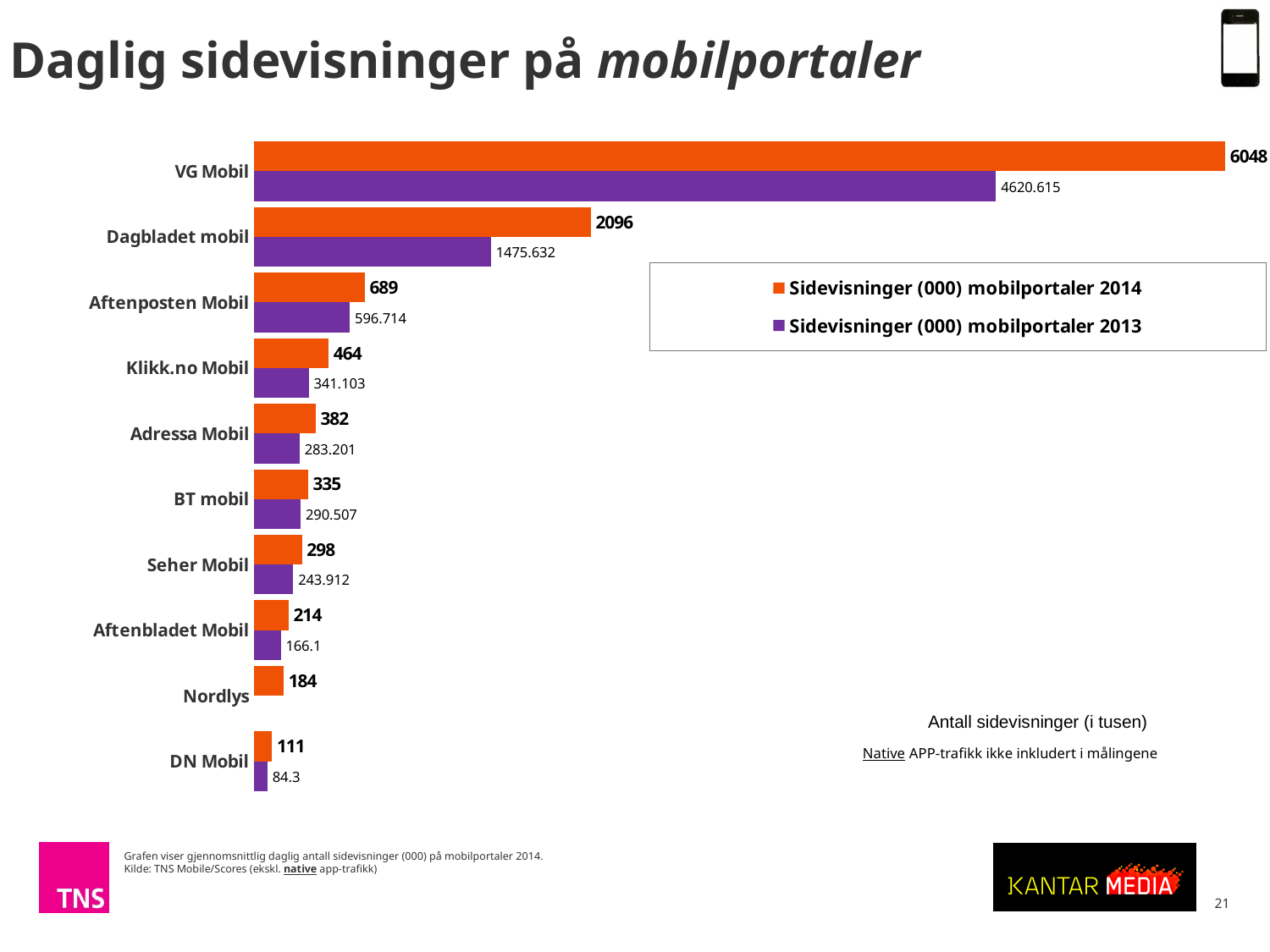
What is the value for Aftenposten Mobil in the Sidevisninger (000) mobilportaler 2014 series? 689 Which category has the lowest value in the Sidevisninger (000) mobilportaler 2014 series? DN Mobil Which category has the highest value in the Sidevisninger (000) mobilportaler 2014 series? VG Mobil What kind of chart is shown on the slide? Bar chart What is the value for Dagbladet mobil in the Sidevisninger (000) mobilportaler 2013 series? 1475.632 How many series does the legend list? 2 What is the value for DN Mobil in the Sidevisninger (000) mobilportaler 2013 series? 84.3 What is the difference between the 2014 values for Aftenposten Mobil and Klikk.no Mobil? 225 What is the value for VG Mobil in the Sidevisninger (000) mobilportaler 2014 series? 6048 Which is larger in the Sidevisninger (000) mobilportaler 2013 series: Adressa Mobil or BT mobil? BT mobil How many categories are shown on the chart? 10 What is the difference between the 2014 values for VG Mobil and Dagbladet mobil? 3952